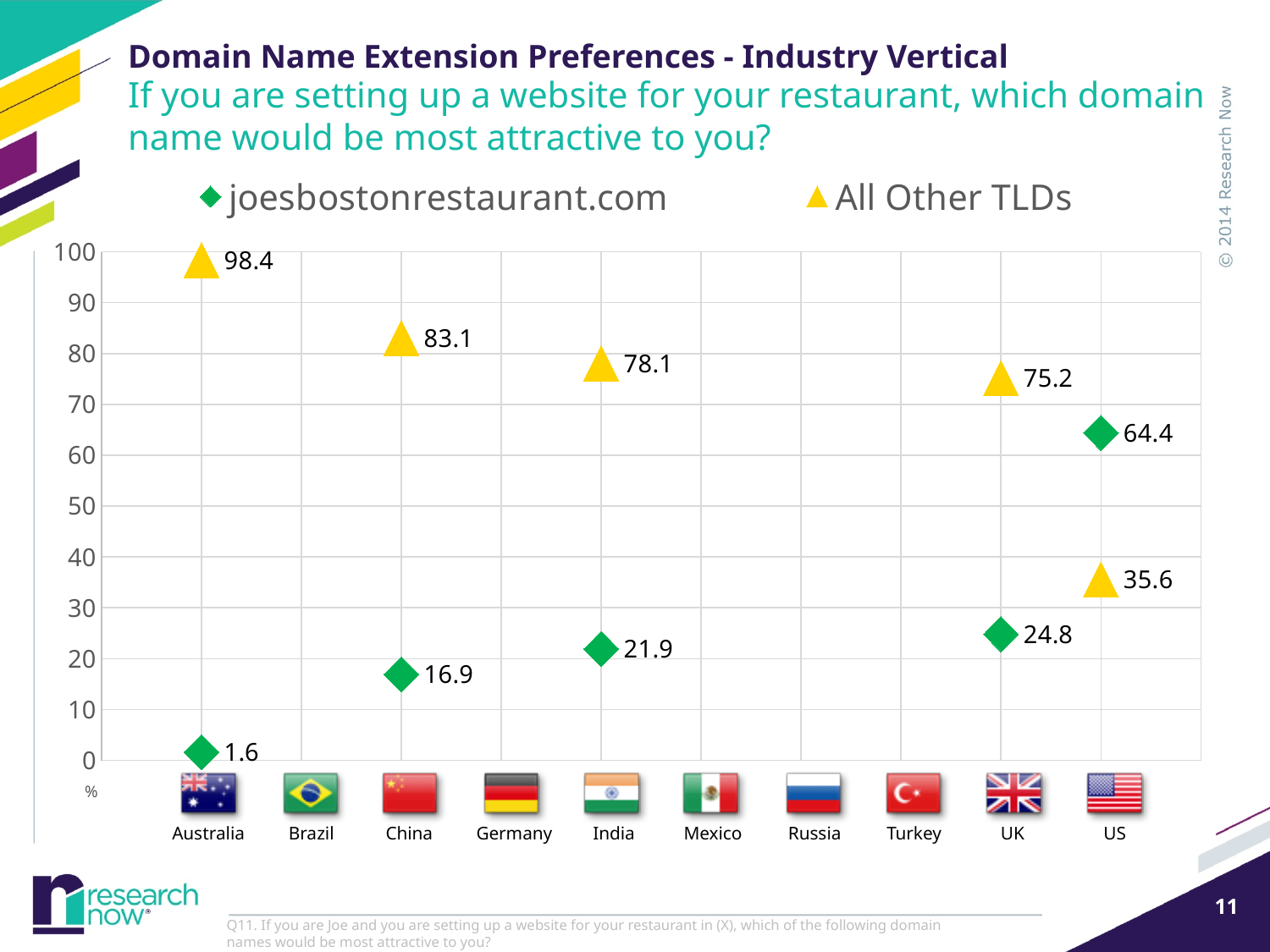
What is the value for joesbostonrestaurant.com in China? 16.9 What is the value for All Other TLDs in the UK? 75.2 Which country has the highest value for joesbostonrestaurant.com? US Is the value for All Other TLDs in China greater or less than 80? greater What is the value for All Other TLDs in Australia? 98.4 How many series does the legend list? 2 Which country has the lowest value for All Other TLDs? US What marker shape is used for the All Other TLDs series? Triangle What is the value for joesbostonrestaurant.com in the US? 64.4 How many countries are labelled on the x axis? 10 Which is larger in the UK: the value for joesbostonrestaurant.com or the value for All Other TLDs? All Other TLDs What is the difference between the All Other TLDs value and the joesbostonrestaurant.com value in India? 56.2